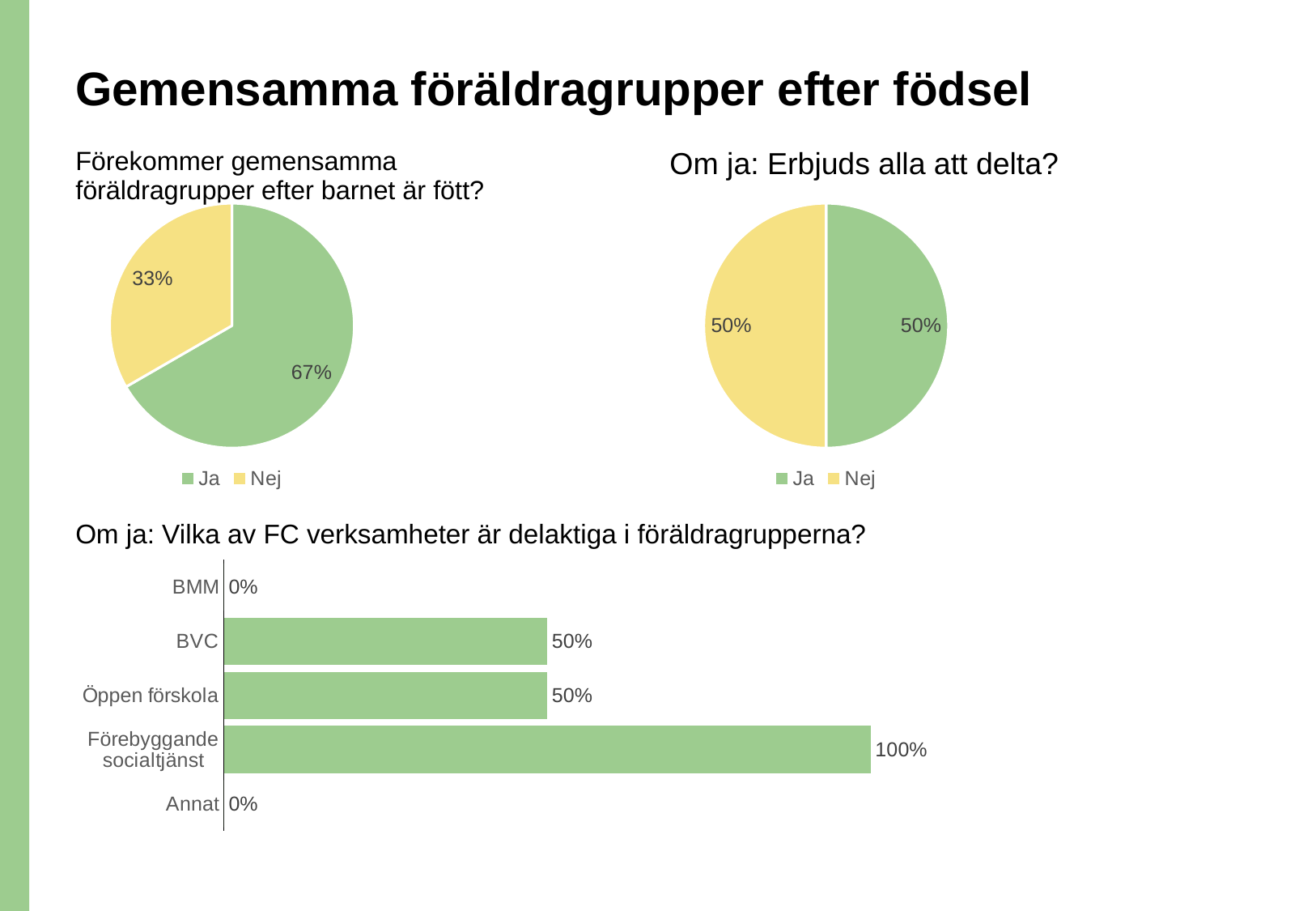
In the pie chart titled 'Förekommer gemensamma föräldragrupper efter barnet är fött?', what share is 'Ja'? 67% In the bar chart titled 'Om ja: Vilka av FC verksamheter är delaktiga i föräldragrupperna?', what is the value for 'Förebyggande socialtjänst'? 100% In the bar chart titled 'Om ja: Vilka av FC verksamheter är delaktiga i föräldragrupperna?', which category has the highest value? Förebyggande socialtjänst In the bar chart titled 'Om ja: Vilka av FC verksamheter är delaktiga i föräldragrupperna?', what is the value for 'BVC'? 50% In the bar chart titled 'Om ja: Vilka av FC verksamheter är delaktiga i föräldragrupperna?', what is the difference between 'Förebyggande socialtjänst' and 'Öppen förskola'? 50% In the pie chart titled 'Förekommer gemensamma föräldragrupper efter barnet är fött?', what share is 'Nej'? 33% In the pie chart titled 'Förekommer gemensamma föräldragrupper efter barnet är fött?', which slice is larger, 'Ja' or 'Nej'? Ja In the pie chart titled 'Om ja: Erbjuds alla att delta?', what share is 'Ja'? 50% In the bar chart titled 'Om ja: Vilka av FC verksamheter är delaktiga i föräldragrupperna?', how many categories are shown? 5 In the bar chart titled 'Om ja: Vilka av FC verksamheter är delaktiga i föräldragrupperna?', what is the value for 'Annat'? 0% In the pie chart titled 'Om ja: Erbjuds alla att delta?', how many entries does the legend list? 2 What kind of chart is the chart titled 'Om ja: Vilka av FC verksamheter är delaktiga i föräldragrupperna?'? bar chart